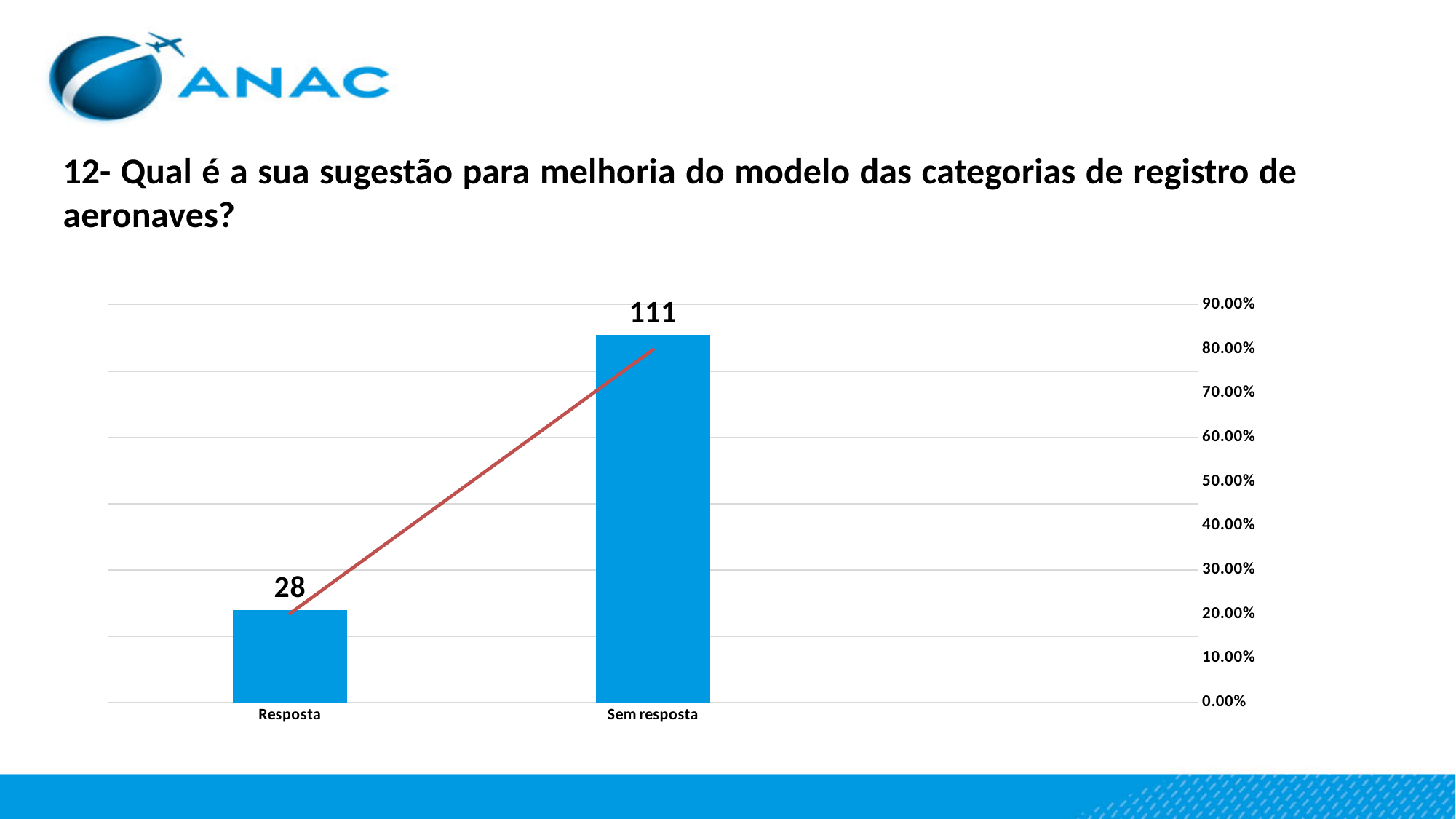
Do the values rise or fall from Resposta to Sem resposta? rise On the percentage axis, is the bar for Resposta greater or less than 30.00%? less Which category has the highest value? Sem resposta On the percentage axis, is the bar for Sem resposta greater or less than 70.00%? greater What kind of chart is shown on the slide? combination bar and line chart What is the value for Sem resposta? 111 What is the difference between the values for Sem resposta and Resposta? 83 What is the value for Resposta? 28 Which is larger, the value for Resposta or the value for Sem resposta? Sem resposta How many categories are shown on the x axis? 2 What colour are the bars in the chart? blue Which category has the lowest value? Resposta